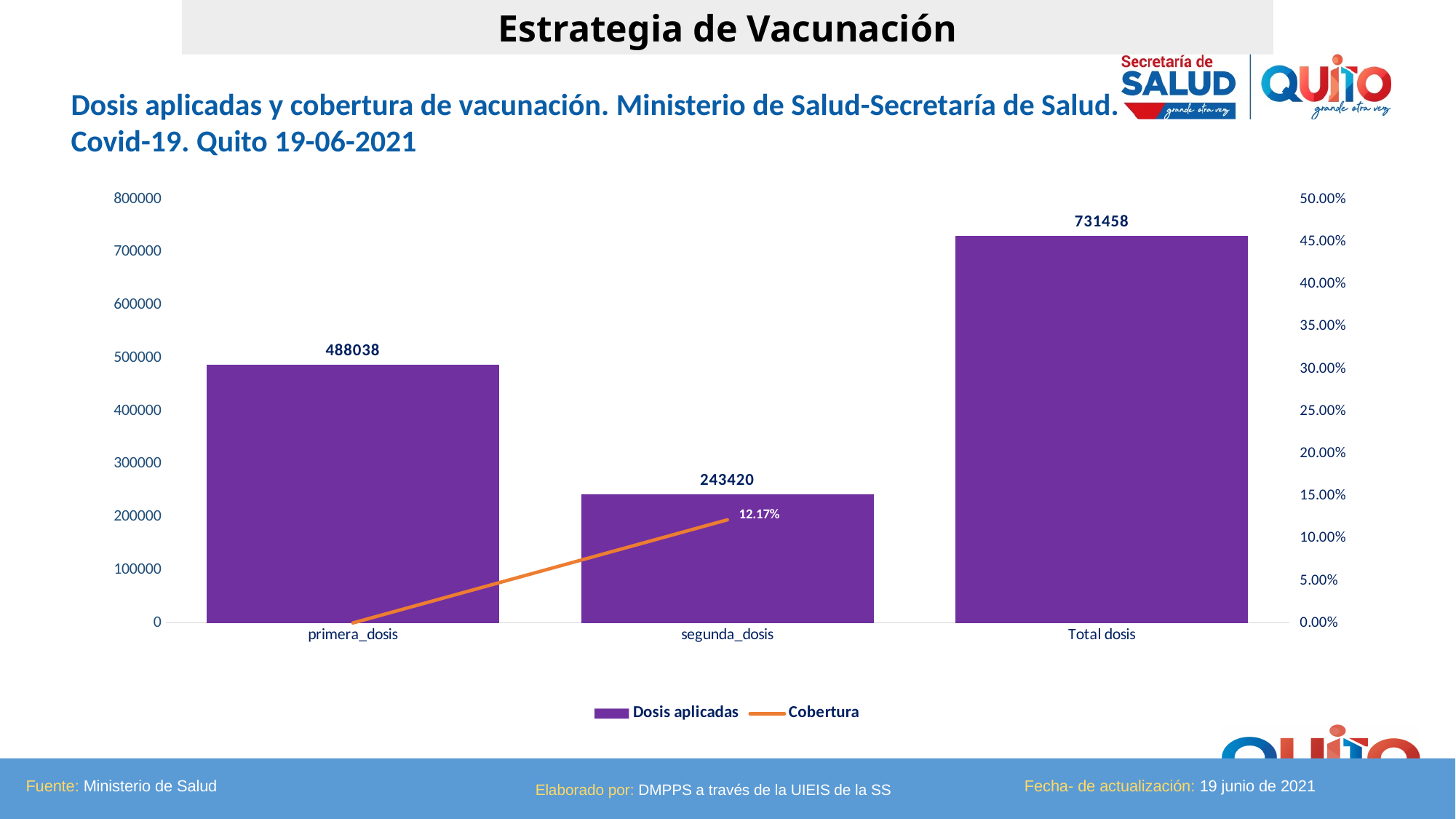
What is the value of Dosis aplicadas for primera_dosis? 488038 Which is larger, the Dosis aplicadas for primera_dosis or for segunda_dosis? primera_dosis Is the Dosis aplicadas value for Total dosis greater or less than 700000? greater What series names appear in the legend? Dosis aplicadas, Cobertura What Cobertura value is labelled at segunda_dosis? 12.17% Which category has the highest Dosis aplicadas bar? Total dosis What is the value of Dosis aplicadas for segunda_dosis? 243420 What is the difference in Dosis aplicadas between primera_dosis and segunda_dosis? 244618 How many categories are shown on the x axis? 3 Which category has the lowest Dosis aplicadas bar? segunda_dosis What is the value of Dosis aplicadas for Total dosis? 731458 How many series does the legend list? 2